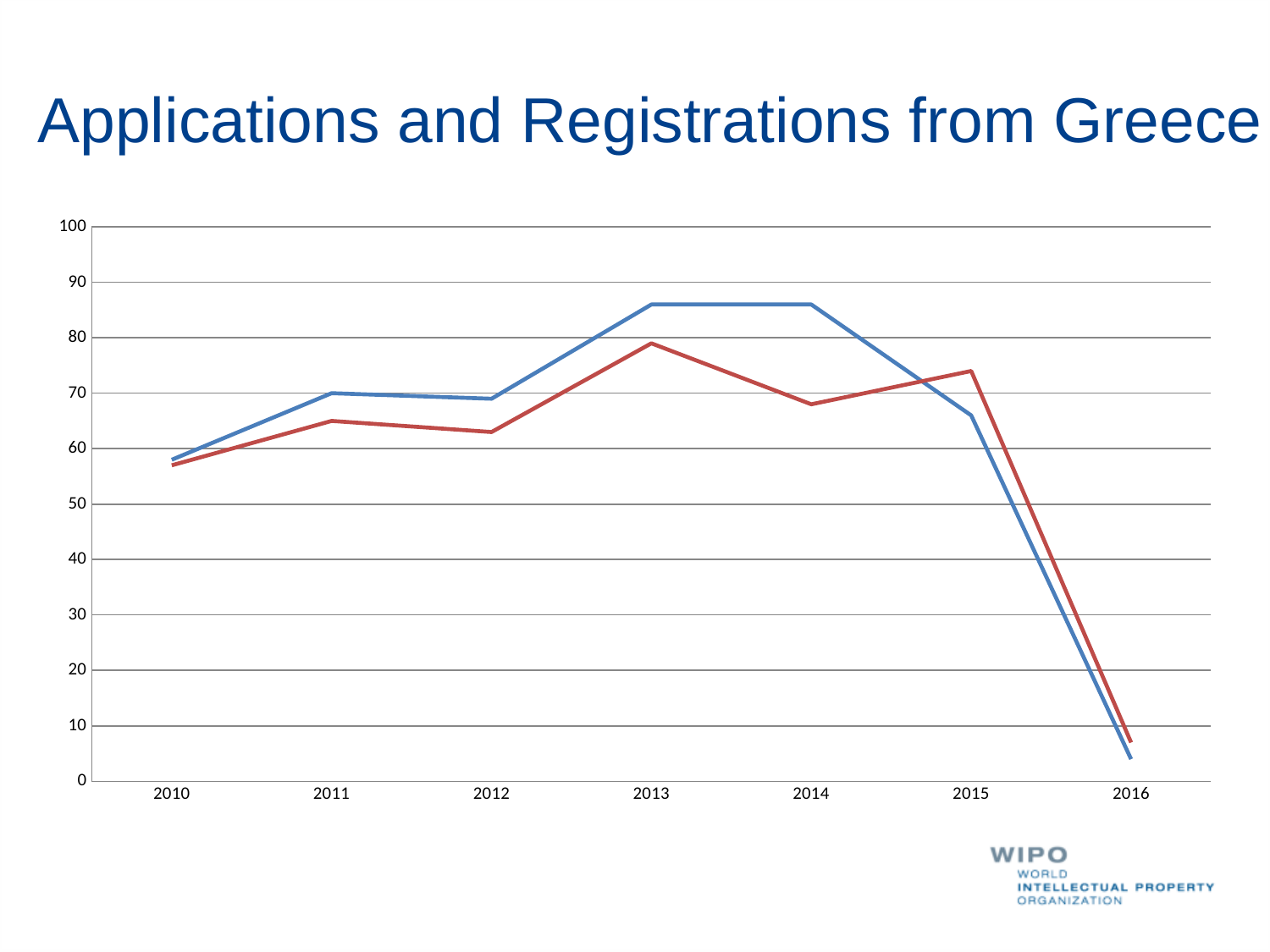
What is the title of the chart slide? Applications and Registrations from Greece Do the values of both lines rise or fall between 2015 and 2016? fall What kind of chart is shown on the slide? line chart Is the value of the red line in 2014 greater or less than 70? less In which year does the red line reach its highest value? 2013 In which year does the blue line reach its lowest value? 2016 How many lines are plotted on the chart? 2 In which year does the red line reach its lowest value? 2016 How many years are shown on the x axis of the chart? 7 In 2013, which line has the higher value, the blue line or the red line? the blue line Is the value of the blue line in 2013 greater or less than 80? greater Is the value of the blue line in 2016 greater or less than 10? less